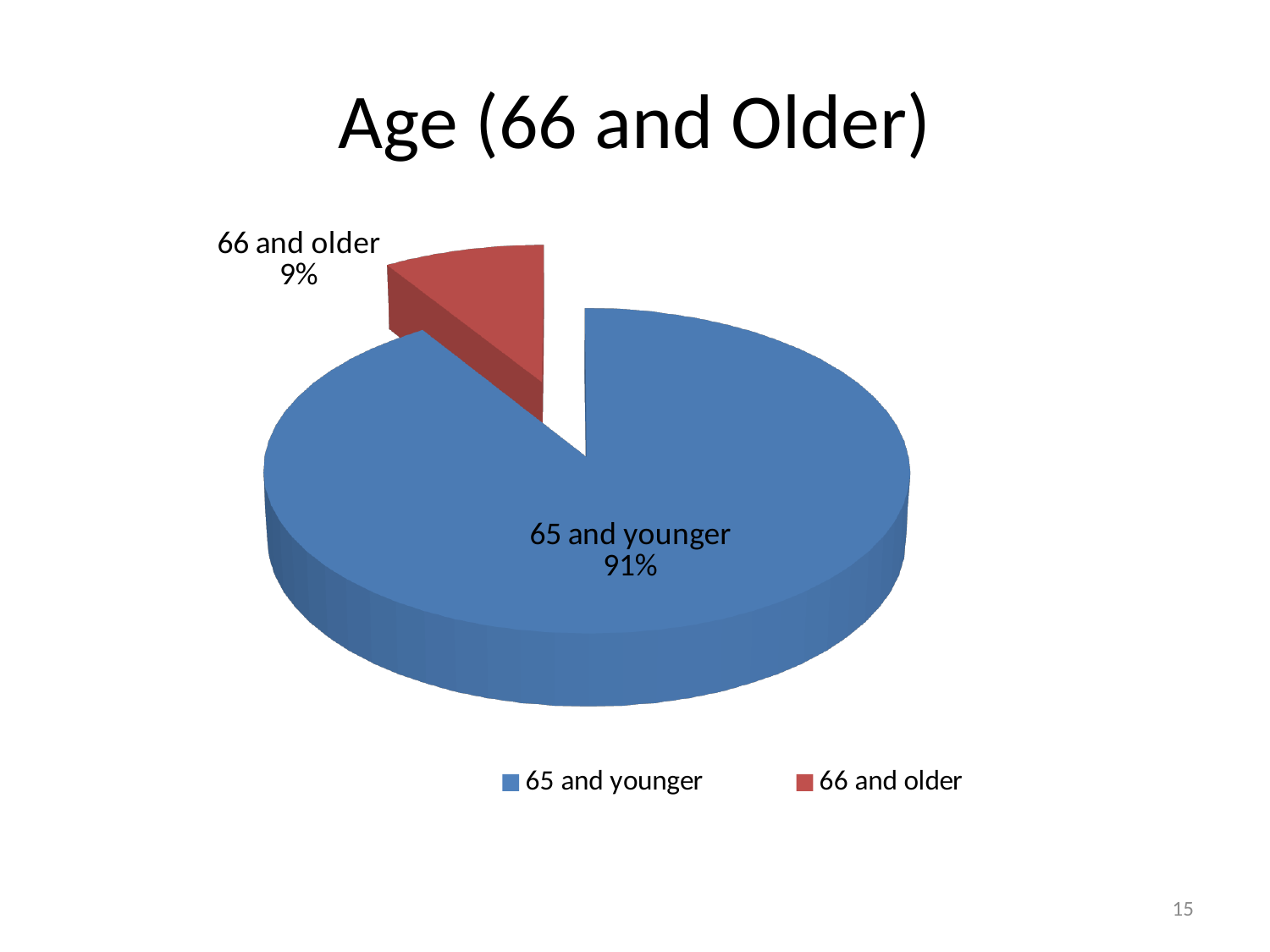
Which category has the largest slice of the pie? 65 and younger Which slice is larger, "65 and younger" or "66 and older"? 65 and younger What share of the pie is labelled "65 and younger"? 91% How many entries does the legend list? 2 What kind of chart is shown on the slide? Pie chart What is the title of the slide? Age (66 and Older) Which category has the smallest slice of the pie? 66 and older What colour is the "66 and older" slice? Red How many slices does the pie chart have? 2 What share of the pie is labelled "66 and older"? 9% What is the difference in percentage points between the "65 and younger" and "66 and older" slices? 82